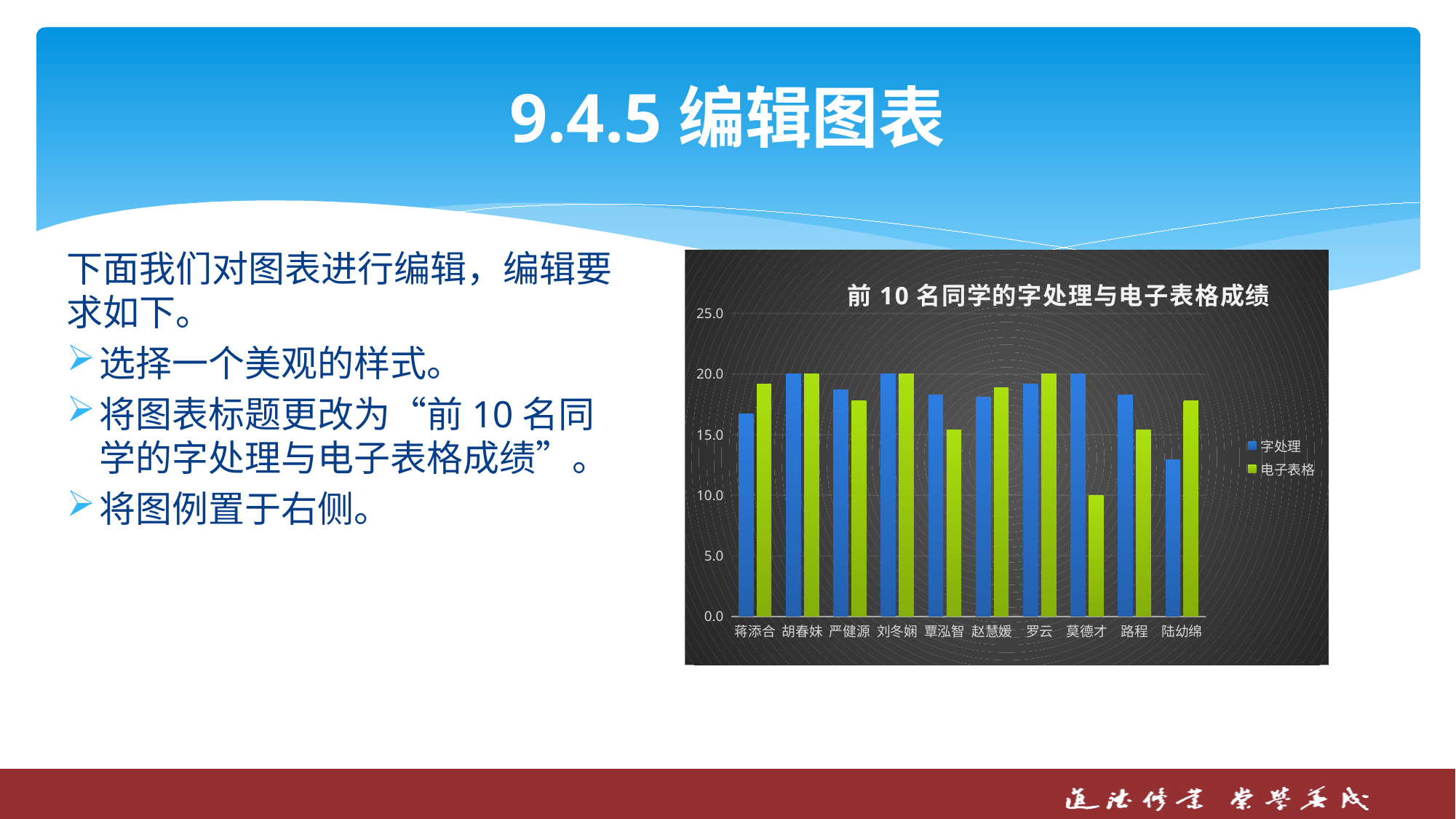
Which student has the lowest 字处理 value? 陆幼绵 How many series does the legend list? 2 What kind of chart is shown on the slide? bar chart Which student has the lowest 电子表格 value? 莫德才 Is the 字处理 value for 陆幼绵 greater or less than 15.0? less For 莫德才, which is larger: the 字处理 value or the 电子表格 value? 字处理 What is the 电子表格 value for 莫德才? 10.0 Is the 电子表格 value for 严健源 greater or less than 15.0? greater What is the 字处理 value for 胡春妹? 20.0 What is the title of the chart? 前 10 名同学的字处理与电子表格成绩 Which series is shown in green in the chart? 电子表格 How many students are shown on the x axis of the chart? 10